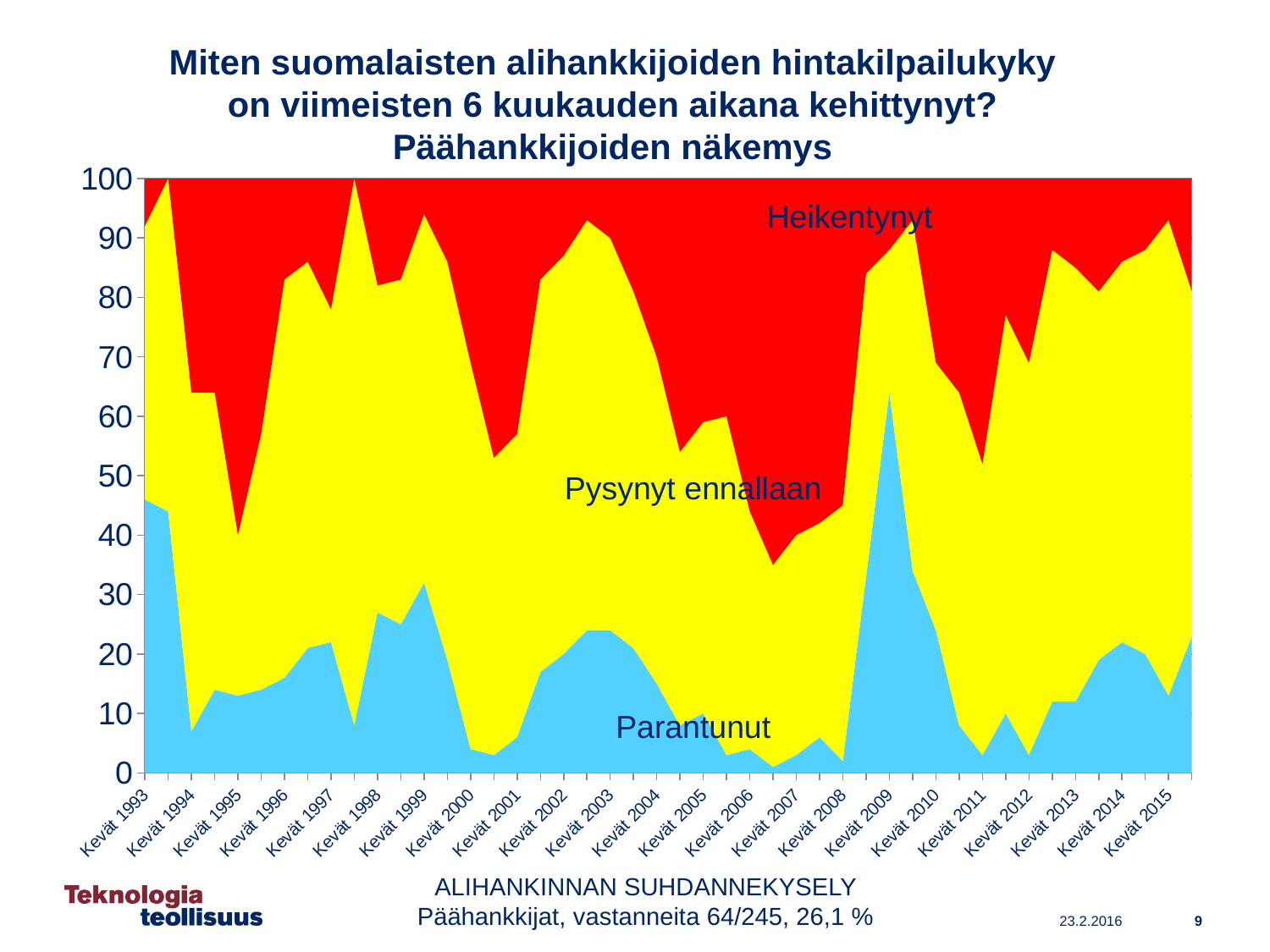
Does the Parantunut series rise or fall between Kevät 2009 and Kevät 2011? Fall Is the value for Parantunut at Kevät 1993 greater or less than 30? greater What colour is the Heikentynyt area in the chart? Red What kind of chart is shown on the slide? Stacked area chart How many year labels are shown on the x axis? 23 Is the value for Parantunut at Kevät 2009 greater or less than 50? greater Which series is plotted at the bottom of the stacked area chart? Parantunut At which x-axis label does the Parantunut series reach its highest value? Kevät 2009 Is the value for Parantunut at Kevät 2003 greater or less than 30? less How many series are plotted in the chart? 3 Which is larger, the Parantunut value at Kevät 2009 or at Kevät 2007? Kevät 2009